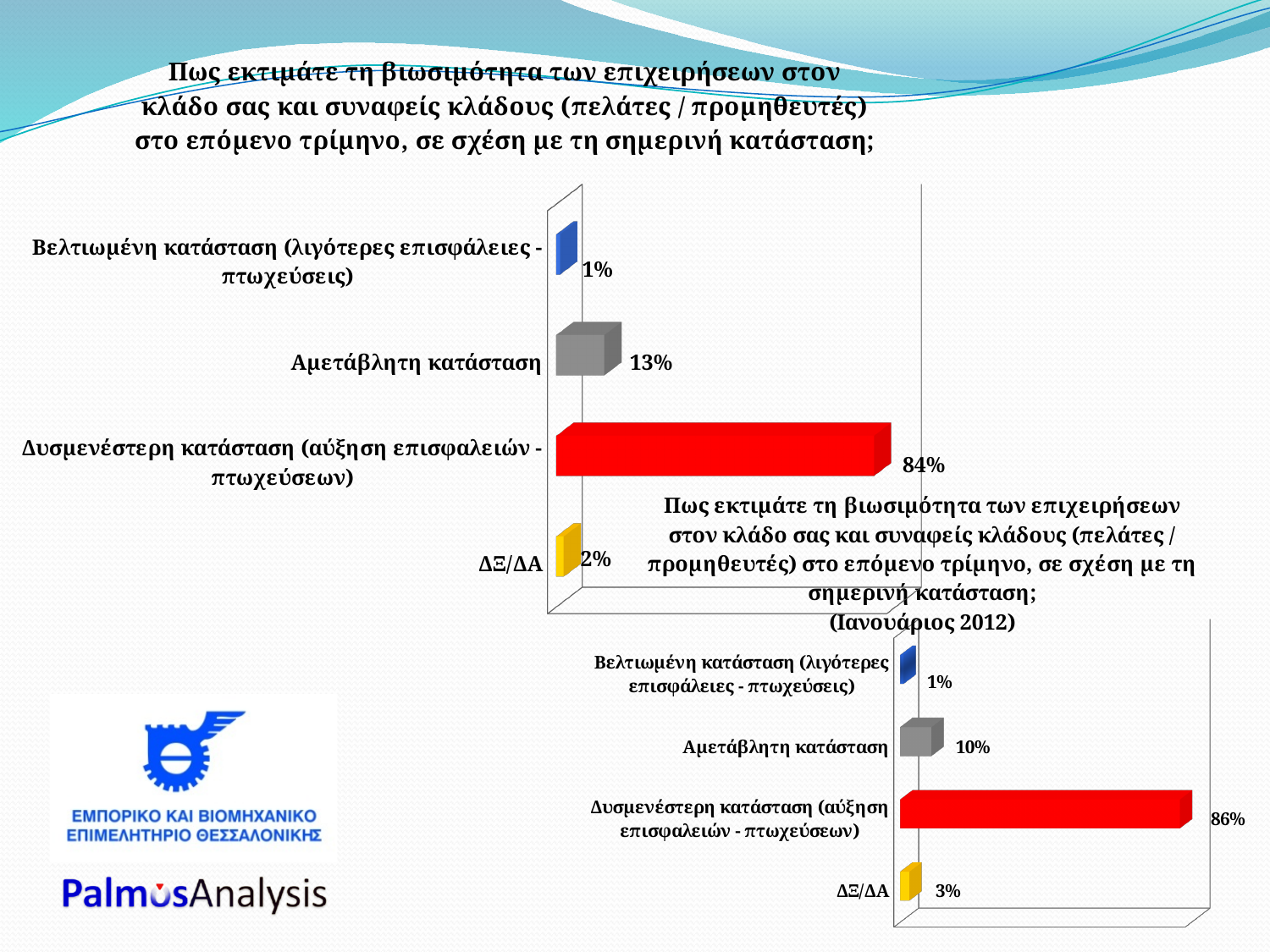
In the larger chart at the top of the slide, what is the value for ΔΞ/ΔΑ? 2% In the larger chart at the top of the slide, how many categories are shown? 4 What kind of chart is the larger chart at the top of the slide? Bar chart In the larger chart at the top of the slide, what is the value for Δυσμενέστερη κατάσταση (αύξηση επισφαλειών - πτωχεύσεων)? 84% In the larger chart at the top of the slide, which category has the lowest value? Βελτιωμένη κατάσταση (λιγότερες επισφάλειες - πτωχεύσεις) In the larger chart at the top of the slide, what is the value for Αμετάβλητη κατάσταση? 13% In the larger chart at the top of the slide, what is the difference between Δυσμενέστερη κατάσταση and Αμετάβλητη κατάσταση? 71 percentage points What colour is the bar for Δυσμενέστερη κατάσταση in the larger chart at the top of the slide? Red In the smaller chart at the bottom right (Ιανουάριος 2012), which category has the highest value? Δυσμενέστερη κατάσταση (αύξηση επισφαλειών - πτωχεύσεων) In the smaller chart at the bottom right (Ιανουάριος 2012), what is the value for Δυσμενέστερη κατάσταση (αύξηση επισφαλειών - πτωχεύσεων)? 86% In the smaller chart at the bottom right (Ιανουάριος 2012), which is larger: ΔΞ/ΔΑ or Βελτιωμένη κατάσταση? ΔΞ/ΔΑ In the smaller chart at the bottom right (Ιανουάριος 2012), what is the value for Αμετάβλητη κατάσταση? 10%